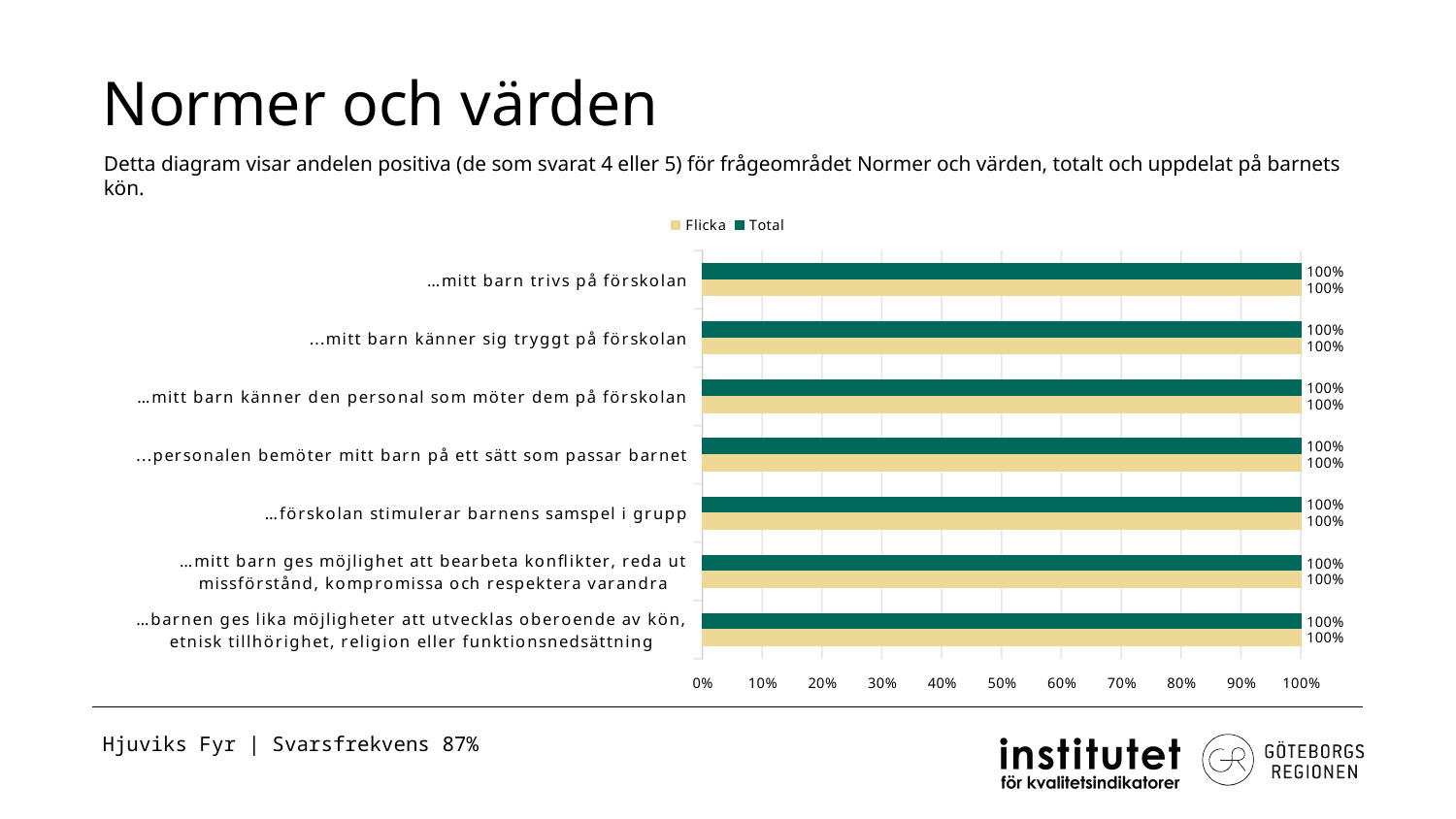
What is the Flicka value for "...mitt barn känner sig tryggt på förskolan"? 100% What is the Total value for "…förskolan stimulerar barnens samspel i grupp"? 100% What is the Flicka value for "…barnen ges lika möjligheter att utvecklas oberoende av kön, etnisk tillhörighet, religion eller funktionsnedsättning"? 100% What is the highest value shown on the x axis? 100% How many series does the legend list? 2 Is the Total value for "…mitt barn känner den personal som möter dem på förskolan" greater or less than 50%? greater Which series are listed in the legend? Flicka and Total What is the difference between the Flicka and Total values for "...personalen bemöter mitt barn på ett sätt som passar barnet"? 0 percentage points How many categories (statements) are plotted in the chart? 7 What kind of chart is shown on the slide? bar chart What is the Total value for "…mitt barn trivs på förskolan"? 100% What is the Total value for "…mitt barn ges möjlighet att bearbeta konflikter, reda ut missförstånd, kompromissa och respektera varandra"? 100%